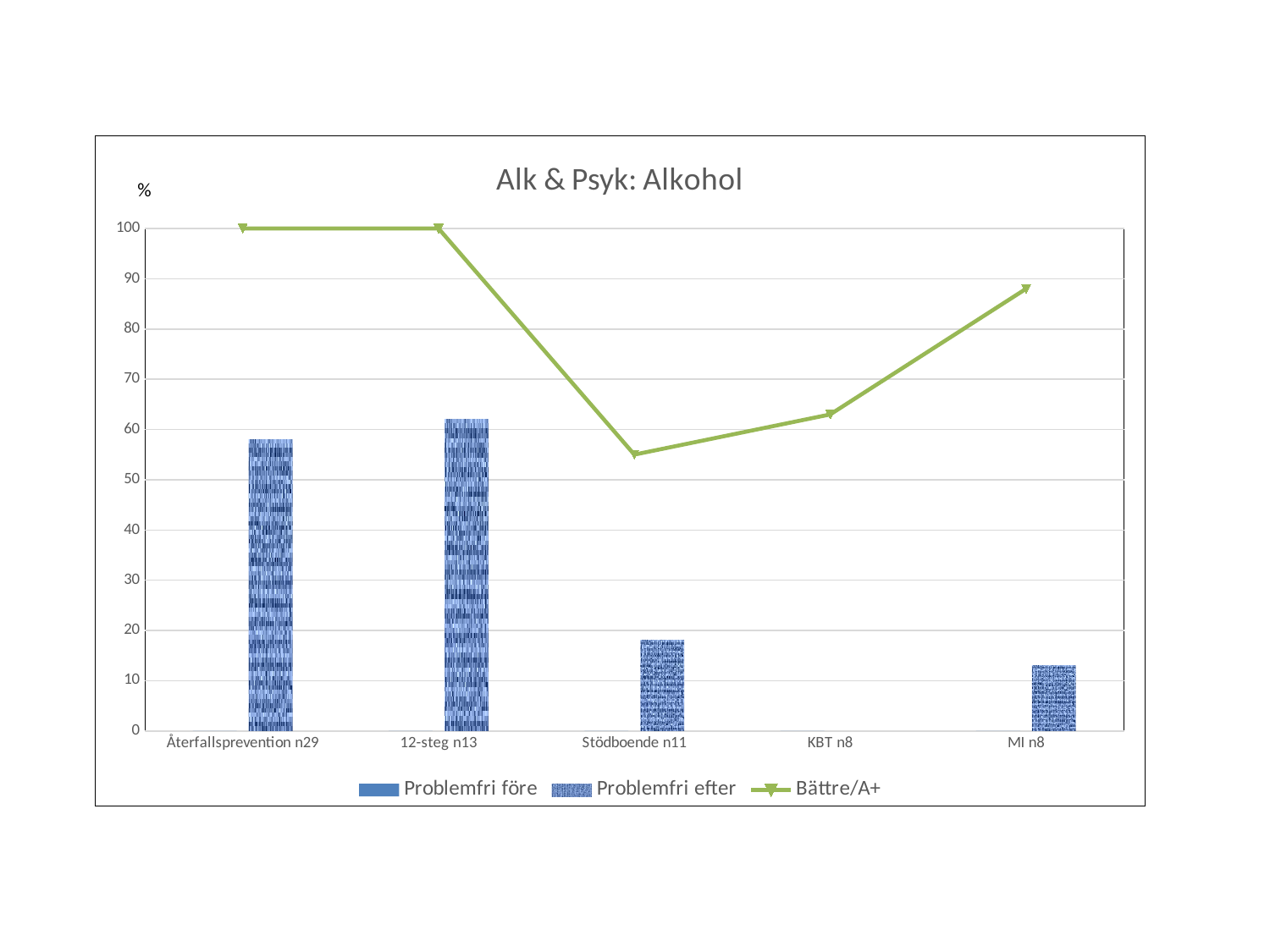
Which category has the lowest Bättre/A+ value? Stödboende n11 How many categories are shown on the x axis? 5 Is the Bättre/A+ value for MI n8 greater or less than 80? greater Is the Bättre/A+ value for KBT n8 greater or less than 70? less Which has the larger Problemfri efter value, Återfallsprevention n29 or Stödboende n11? Återfallsprevention n29 What is the Bättre/A+ value for Återfallsprevention n29? 100 What is the Bättre/A+ value for 12-steg n13? 100 Which category has the highest Problemfri efter bar? 12-steg n13 How many series does the legend list? 3 What kind of chart is shown on the slide? A combined bar and line chart What is the title of the chart? Alk & Psyk: Alkohol Is the Problemfri efter value for Stödboende n11 greater or less than 20? less